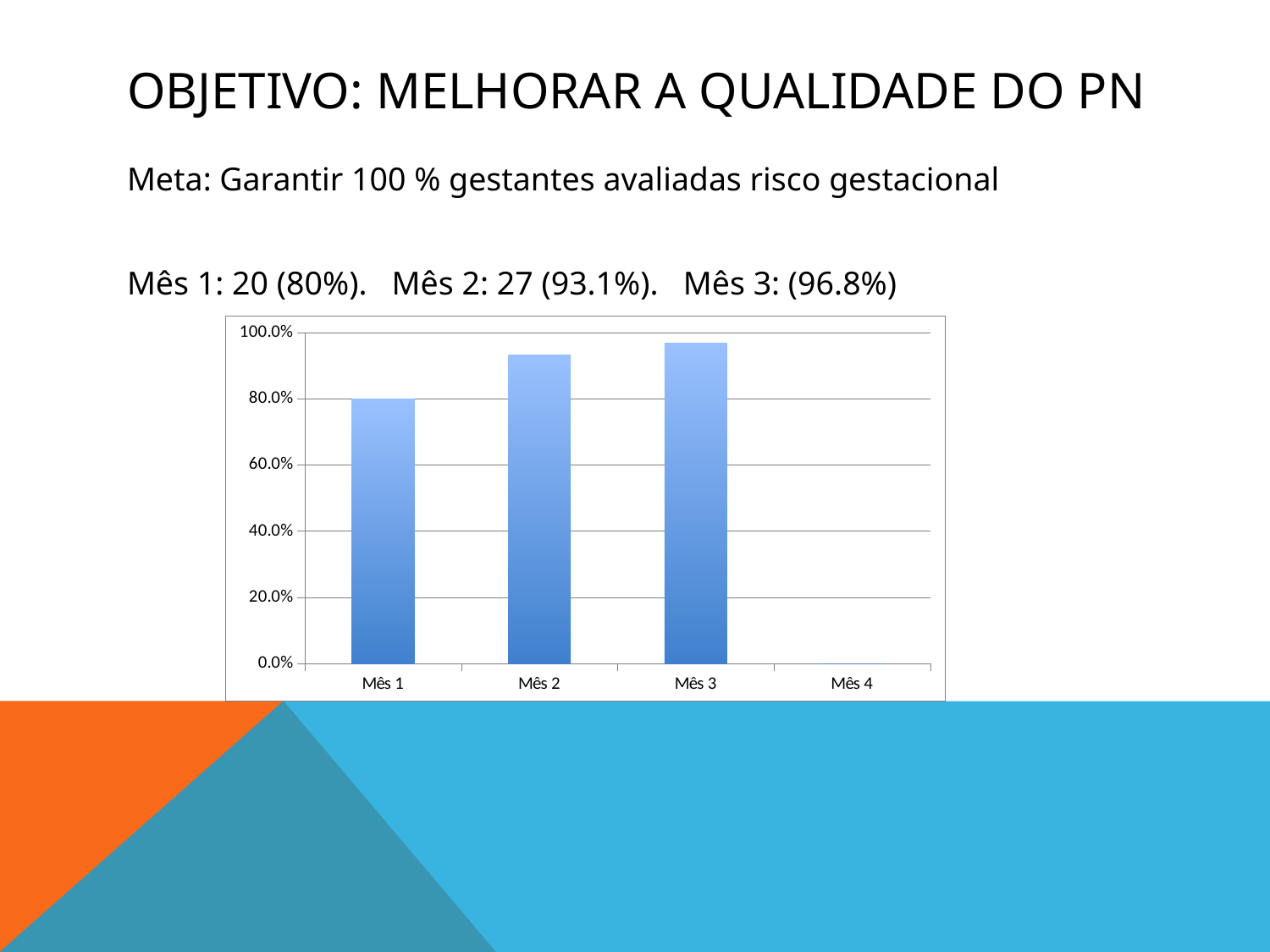
Which category on the x axis has no visible bar? Mês 4 What is the difference between the values for Mês 3 and Mês 2? 3.7% What is the value for Mês 3 in the chart? 96.8% What is the value for Mês 1 in the chart? 80% Among Mês 1, Mês 2 and Mês 3, which has the lowest value? Mês 1 What is the value for Mês 2 in the chart? 93.1% Do the values rise or fall from Mês 1 to Mês 3? rise What kind of chart is shown on the slide? bar chart Which is larger, the value for Mês 2 or the value for Mês 3? Mês 3 Which category has the highest bar in the chart? Mês 3 How many categories are shown on the x axis of the chart? 4 Is the value for Mês 2 greater or less than 80.0%? greater